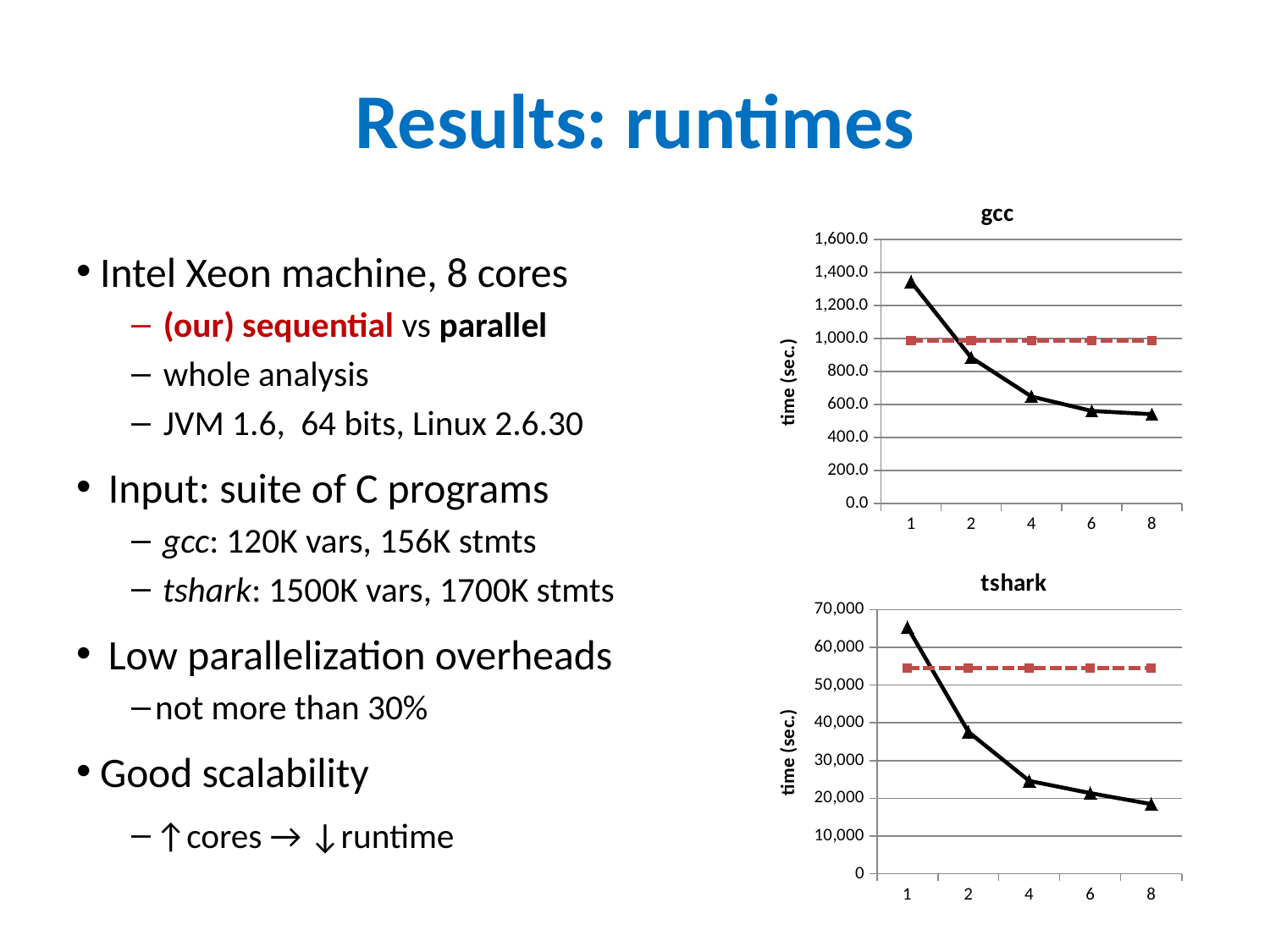
In the tshark chart, how many points are on the x axis? 5 In the tshark chart, is the value of the solid black line at x = 1 greater or less than 60,000? greater What is the y-axis title of the gcc chart? time (sec.) In the gcc chart, how many points are on the x axis? 5 What kind of chart is the tshark chart? line chart In the gcc chart, is the value of the solid black line at x = 8 greater or less than 600.0? less What kind of chart is the gcc chart? line chart In the tshark chart, does the solid black line rise or fall as the x-axis value increases from 1 to 8? fall In the gcc chart, is the value of the solid black line at x = 1 greater or less than 1,200.0? greater In the tshark chart, at x = 8, which line has the larger value: the red dashed line or the solid black line? the red dashed line In the gcc chart, does the solid black line rise or fall as the x-axis value increases from 1 to 8? fall